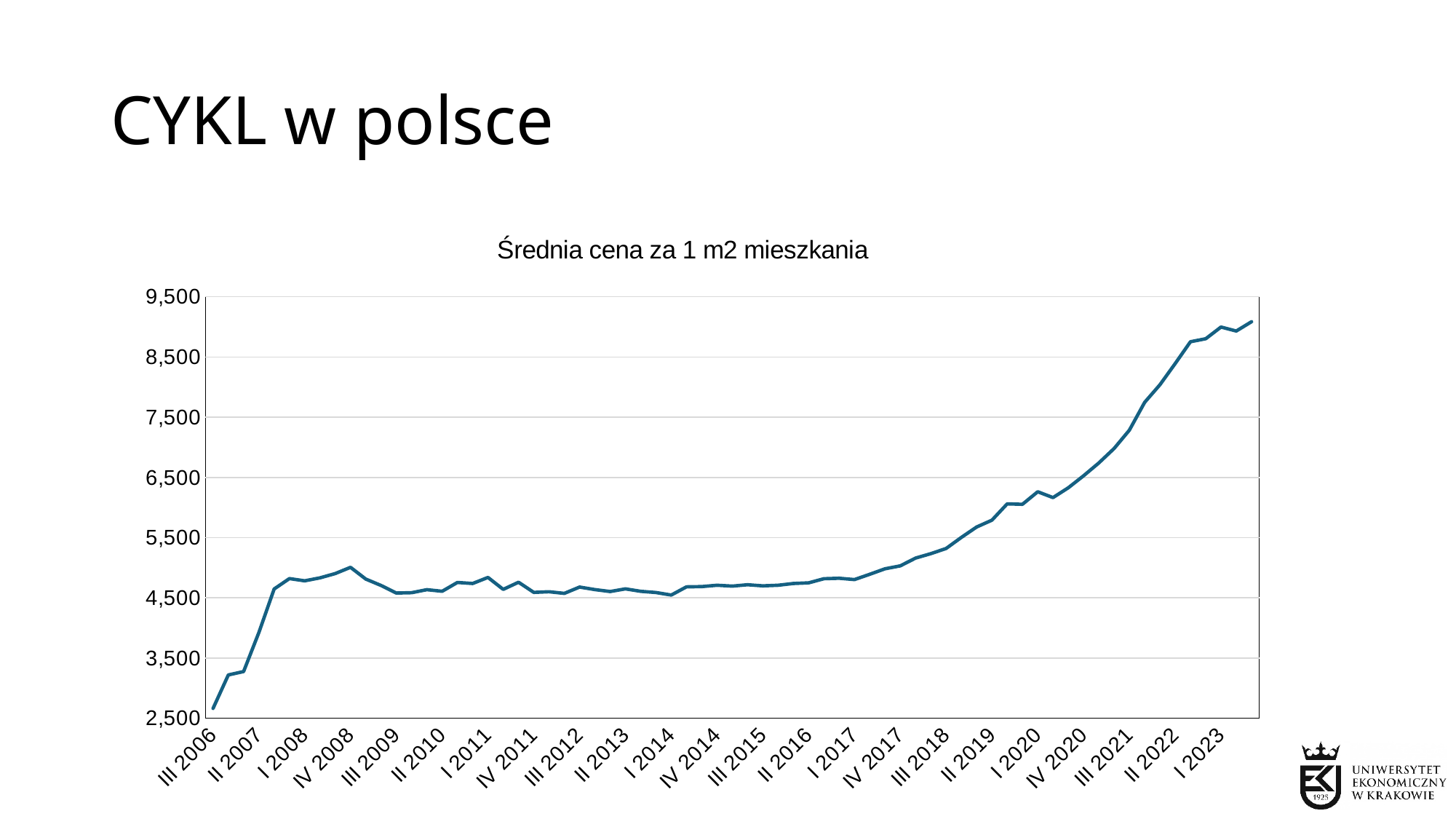
Is the value for I 2023 greater or less than 8,500? greater What is the title of the chart? Średnia cena za 1 m2 mieszkania Is the value for III 2006 greater or less than 3,500? less Is the value for IV 2008 greater or less than 4,500? greater Which labelled period has the lowest value on the chart? III 2006 What is the highest value shown on the vertical axis? 9,500 What kind of chart is shown on the slide? line chart Which is larger, the value for IV 2008 or the value for I 2014? IV 2008 Which is larger, the value for III 2006 or the value for I 2023? I 2023 Overall, do the values rise or fall from III 2006 to the end of the series? rise